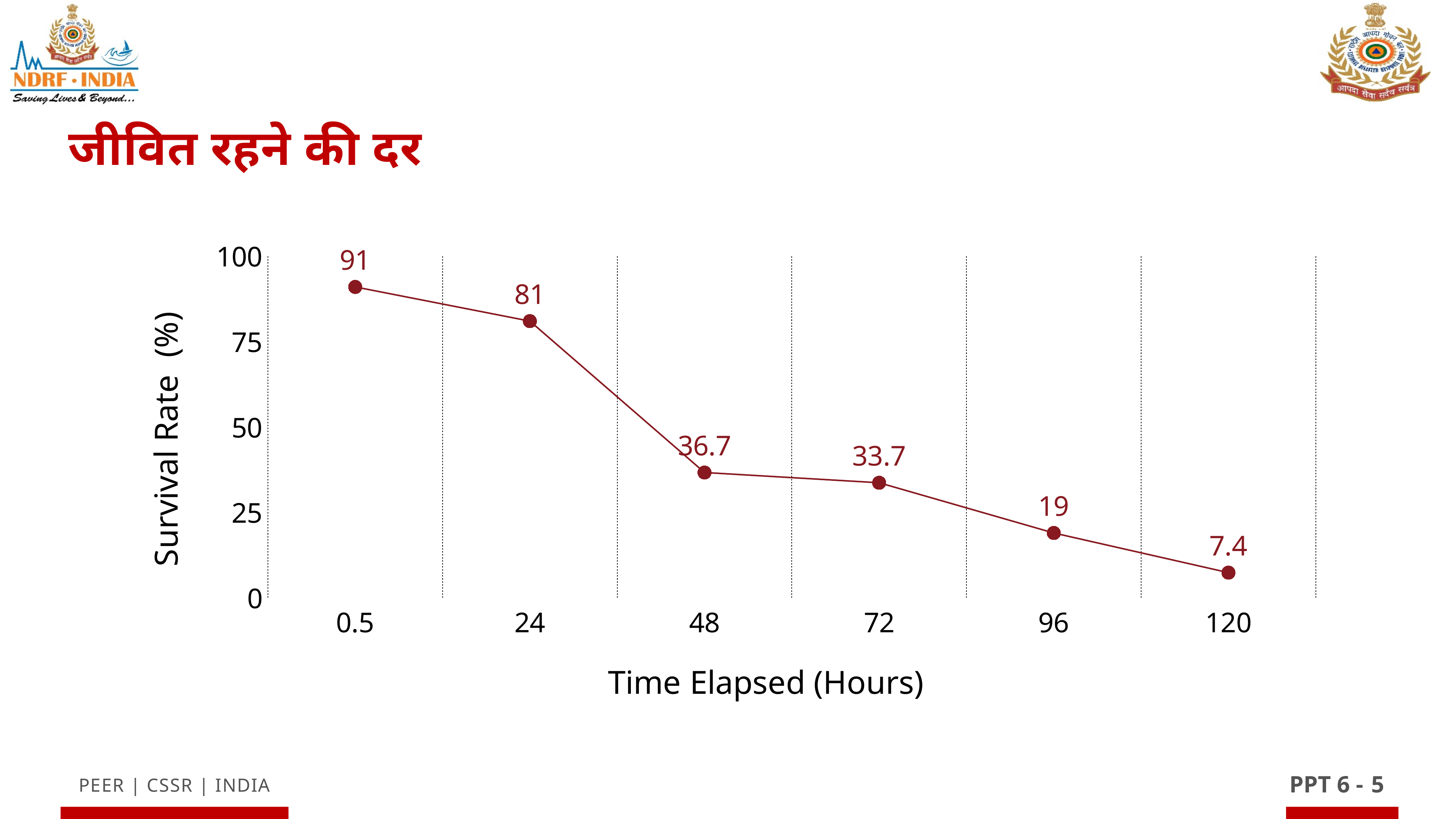
Which has a higher survival rate, 72 hours or 96 hours? 72 At which time elapsed is the survival rate highest? 0.5 What is the difference between the survival rate at 24 hours and at 48 hours? 44.3 What is the survival rate at 120 hours elapsed? 7.4 Does the survival rate rise or fall as time elapsed increases? fall What kind of chart is shown on the slide? line chart What is the survival rate at 48 hours elapsed? 36.7 What is the difference between the survival rate at 96 hours and at 120 hours? 11.6 How many data points are plotted on the chart? 6 What is the survival rate at 0.5 hours elapsed? 91 At which time elapsed is the survival rate lowest? 120 Is the survival rate at 24 hours greater or less than 75? greater